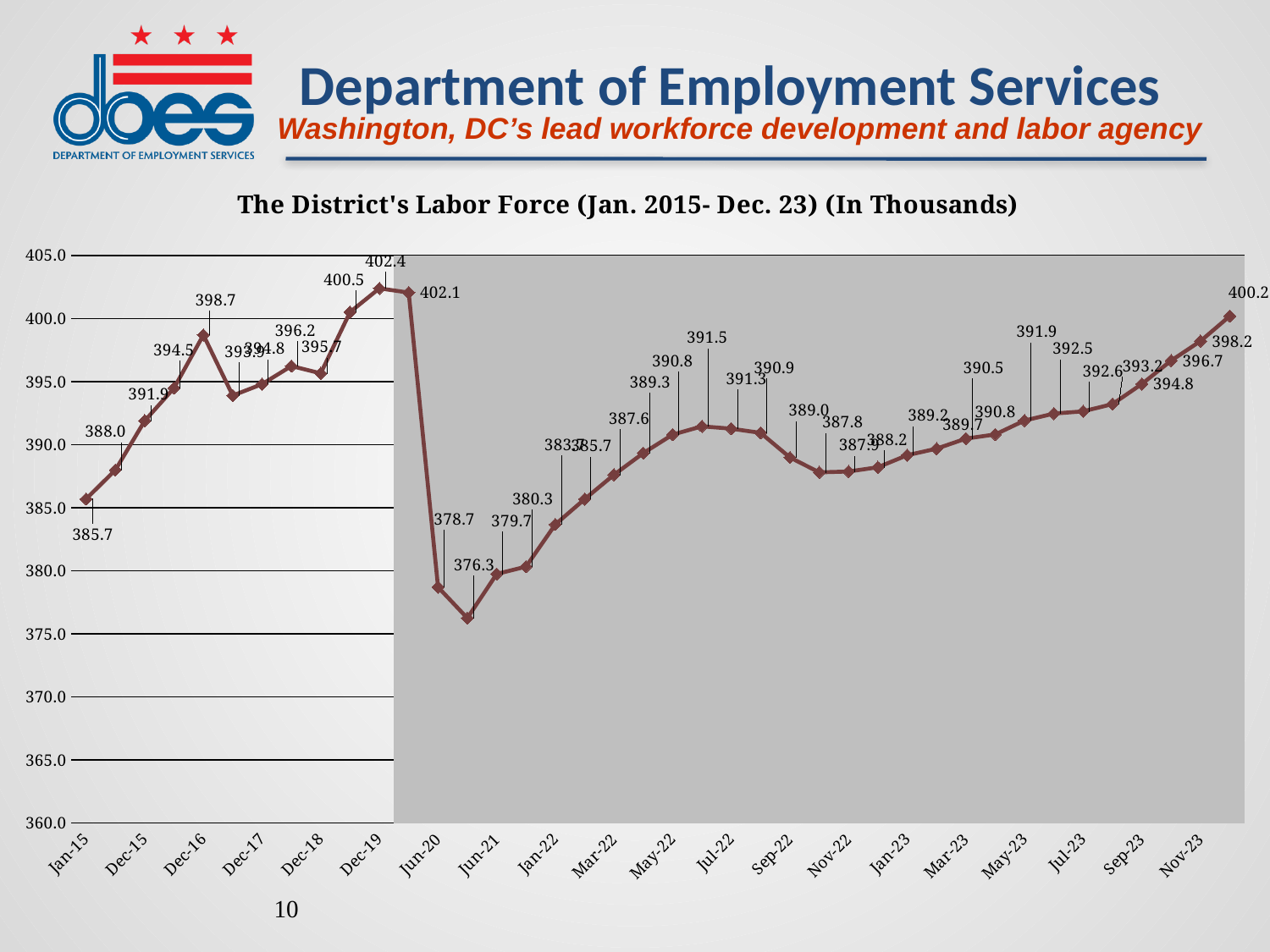
What is the highest labor force value shown on the chart? 402.4 What is the title of the chart? The District's Labor Force (Jan. 2015- Dec. 23) (In Thousands) What is the labor force value for Dec-19? 402.4 What is the labor force value for Jan-15? 385.7 What kind of chart is shown on the slide? line chart Which is larger, the value for Jan-15 or the value for Nov-23? Nov-23 What is the labor force value for Nov-23? 398.2 Is the value for Jun-21 greater or less than 385.0? less What is the labor force value for Jun-20? 378.7 Between Jun-21 and Jul-22, do the values generally rise or fall? rise What is the difference between the Dec-19 value and the Jun-20 value? 23.7 What is the lowest labor force value shown on the chart? 376.3